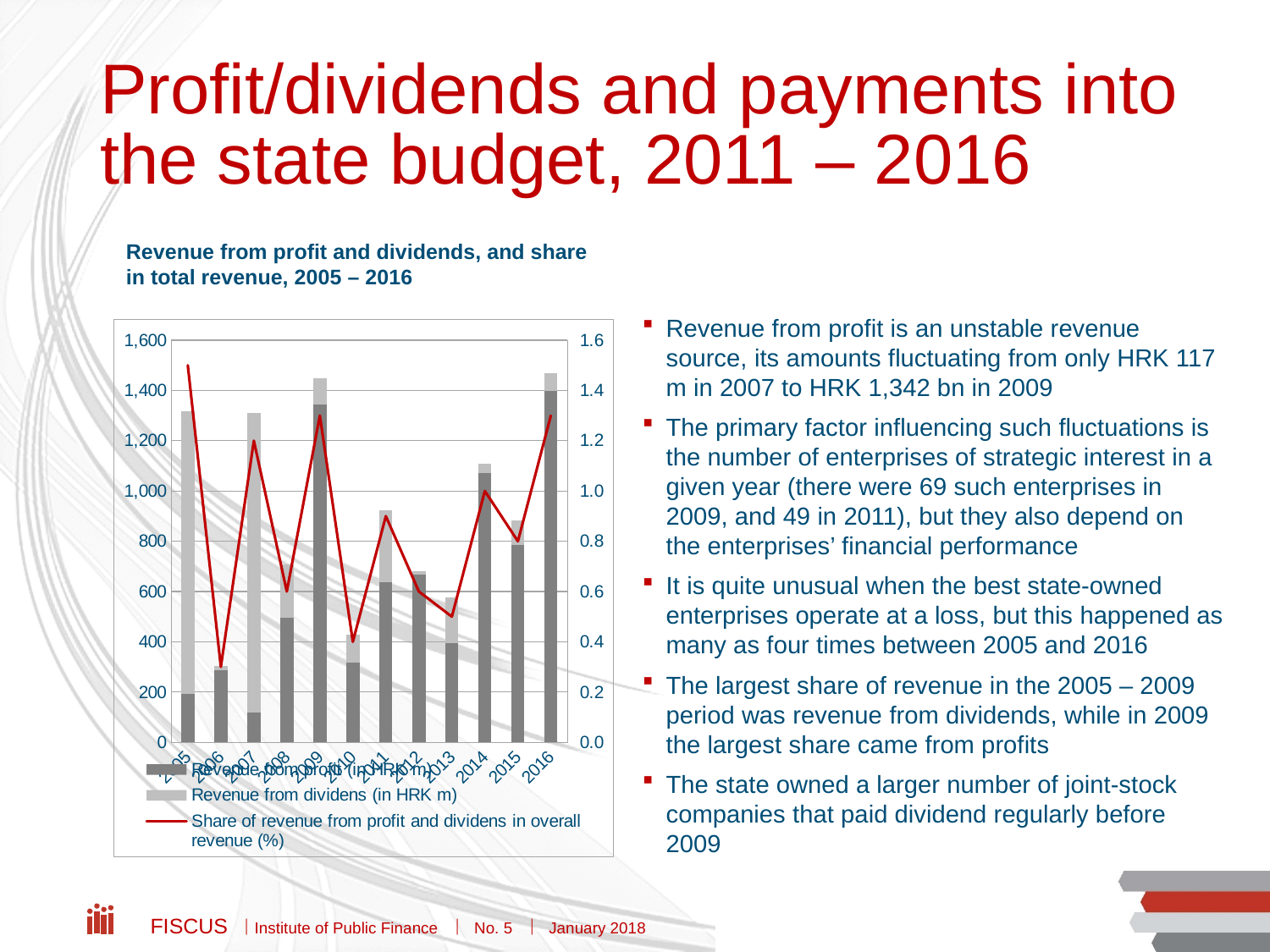
Is the share of revenue from profit and dividends in 2013 greater or less than 0.6? less Does the share of revenue from profit and dividends line rise or fall from 2009 to 2010? fall How many series does the chart legend list? 3 Is the total stacked bar for 2007 greater or less than 1,200? greater Which year has the larger total stacked bar, 2007 or 2008? 2007 What kind of chart is shown on the slide? A stacked bar chart combined with a line Is the share of revenue from profit and dividends in 2005 greater or less than 1.4? greater In which year is the total stacked bar (profit plus dividends) the lowest? 2006 In which year does the share of revenue from profit and dividends line reach its highest value? 2005 What is the title of the chart on the slide? Revenue from profit and dividends, and share in total revenue, 2005 – 2016 How many years are shown on the x axis of the chart? 12